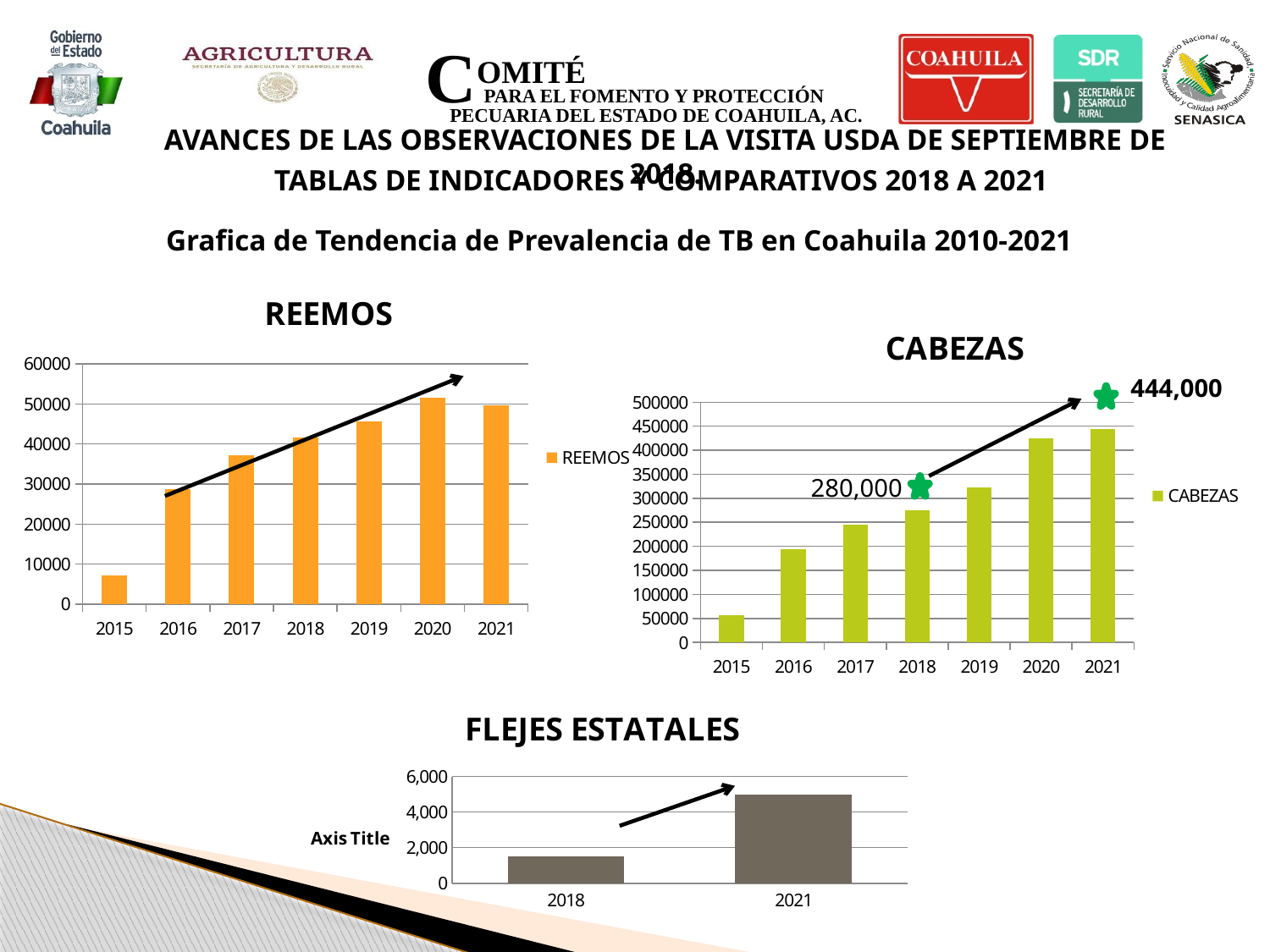
On the FLEJES ESTATALES chart, which year has the larger value, 2018 or 2021? 2021 On the REEMOS chart, which year has the lowest value? 2015 On the REEMOS chart, is the value for 2020 greater or less than 50000? greater On the REEMOS chart, is the value for 2015 greater or less than 10000? less What kind of chart is the FLEJES ESTATALES chart? bar chart On the REEMOS chart, which year has the highest value? 2020 On the REEMOS chart, how many years are shown on the x axis? 7 On the CABEZAS chart, what value is labelled for 2018? 280,000 On the CABEZAS chart, what value is labelled for 2021? 444,000 On the CABEZAS chart, which year has the lowest value? 2015 On the CABEZAS chart, do the values generally rise or fall from 2015 to 2021? rise